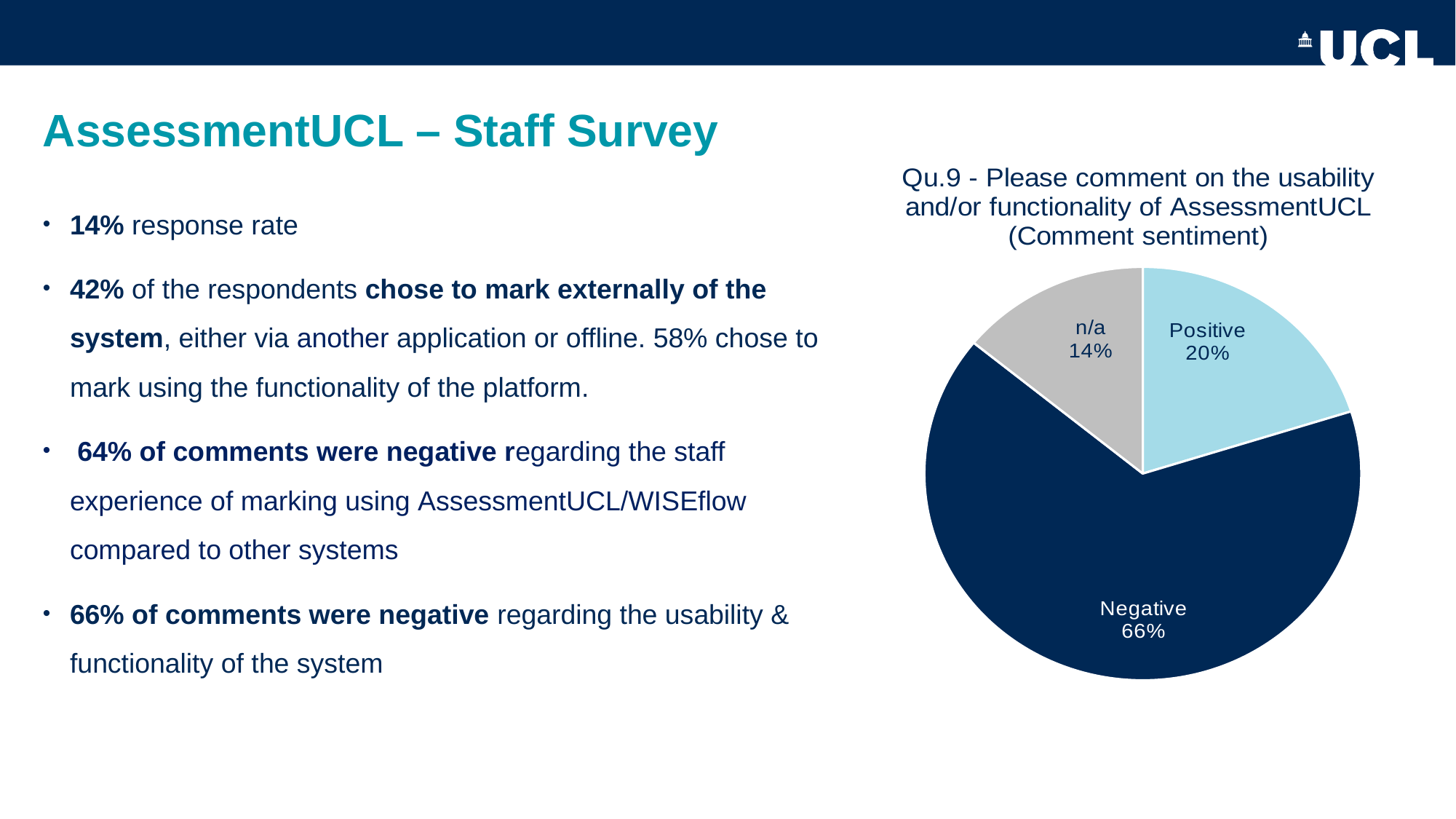
What share of comments is labelled n/a in the pie chart? 14% What type of chart is shown on the slide? pie chart What is the difference in percentage points between the Negative and Positive slices? 46 What is the title of the pie chart? Qu.9 - Please comment on the usability and/or functionality of AssessmentUCL (Comment sentiment) What is the difference in percentage points between the Positive and n/a slices? 6 What share of comments is labelled Negative in the pie chart? 66% Which slice of the pie chart is the smallest? n/a Which is larger in the pie chart, the Positive slice or the n/a slice? Positive Which slice of the pie chart is the largest? Negative What share of comments is labelled Positive in the pie chart? 20% What colour is the Negative slice of the pie chart? dark navy blue How many slices does the pie chart have? 3